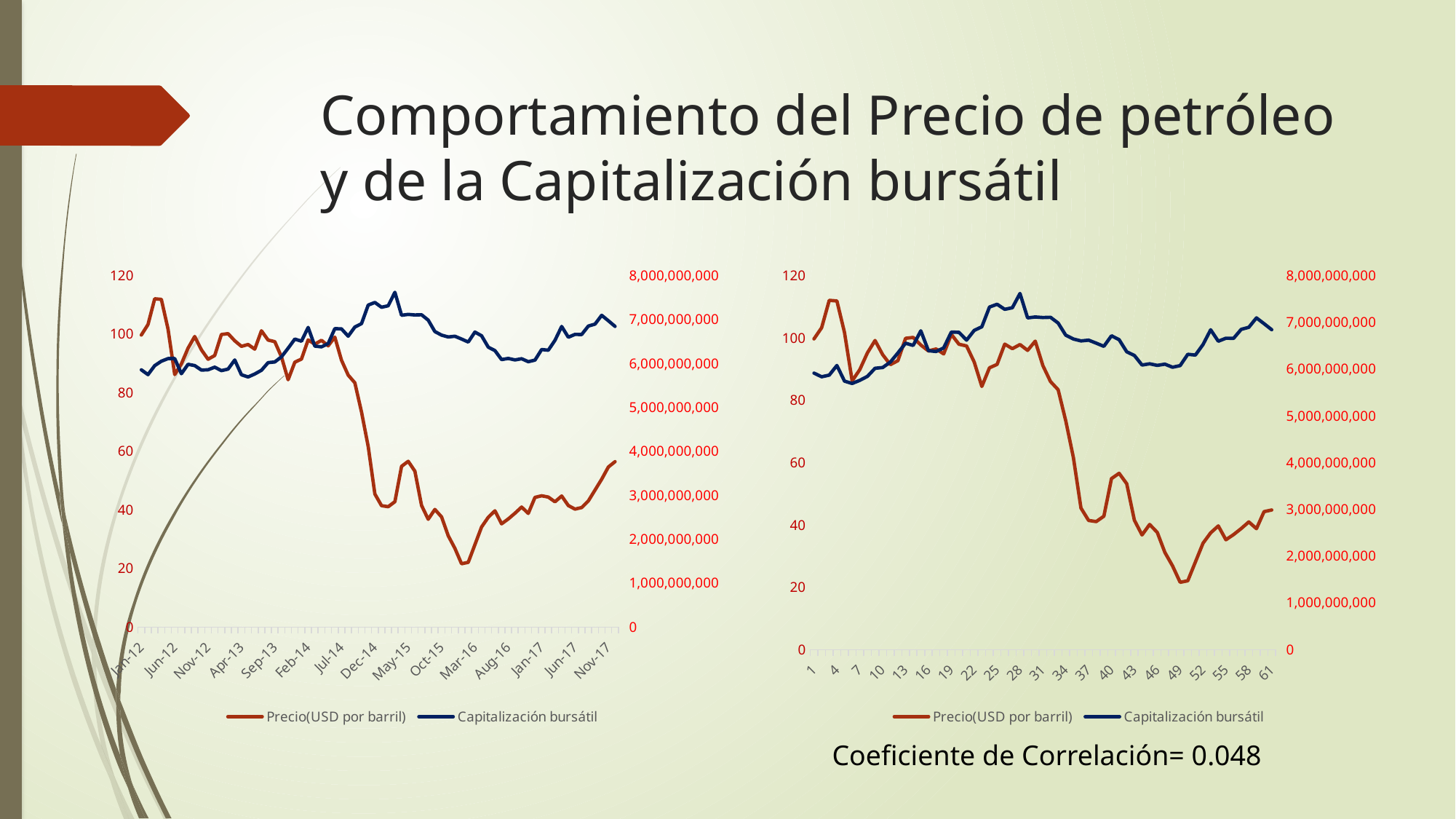
In the left chart, is the value of Precio(USD por barril) at Jan-12 greater or less than 80? greater In the right chart, is the value of Capitalización bursátil at point 49 greater or less than 7,000,000,000? less In the left chart, is the value of Precio(USD por barril) at Mar-16 greater or less than 40? less In the right chart, does Precio(USD por barril) rise or fall between point 49 and point 61? rise What kind of chart is the left chart on the slide? line chart How many series does the legend of the left chart list? 2 What is the correlation coefficient stated below the right chart? 0.048 What kind of chart is the right chart on the slide? line chart In the left chart, does Precio(USD por barril) rise or fall between Jul-14 and Mar-16? fall What are the two series named in the legend of the right chart? Precio(USD por barril) and Capitalización bursátil